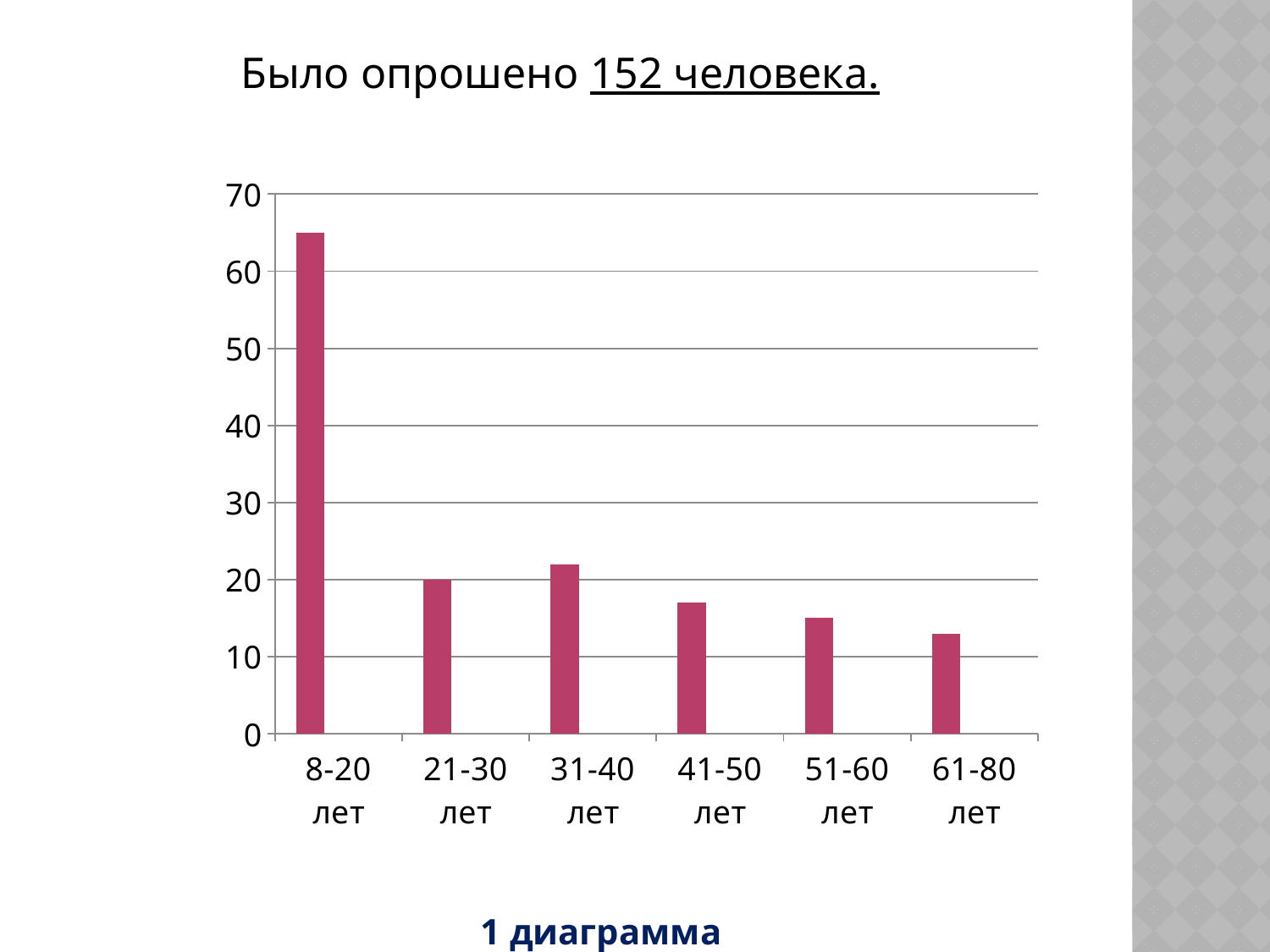
Which age category has the highest bar? 8-20 лет Is the value for 41-50 лет greater or less than 20? less Which is larger, the value for 21-30 лет or the value for 41-50 лет? 21-30 лет What is the title text above the chart? Было опрошено 152 человека. Which is larger, the value for 8-20 лет or the value for 31-40 лет? 8-20 лет What is the value for the 21-30 лет category? 20 Is the value for 8-20 лет greater or less than 60? greater What caption appears below the chart? 1 диаграмма Is the value for 31-40 лет greater or less than 20? greater How many age categories are shown on the x axis? 6 What type of chart is shown on the slide? bar chart